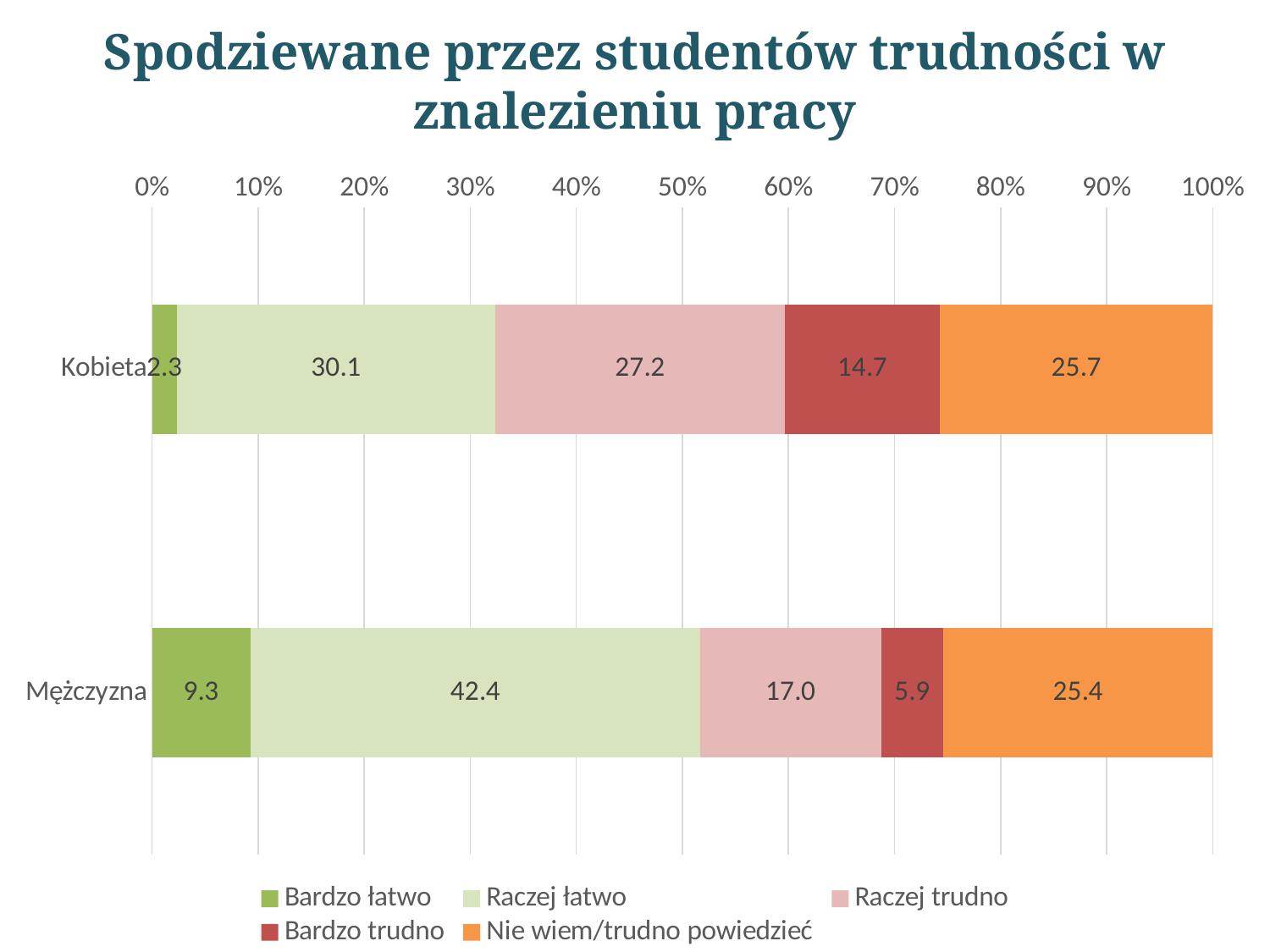
What is the value of "Bardzo trudno" for Mężczyzna? 5.9 What is the value of "Raczej łatwo" for Kobieta? 30.1 What is the difference between the "Raczej łatwo" values for Mężczyzna and Kobieta? 12.3 Which category has the higher value for "Raczej łatwo", Kobieta or Mężczyzna? Mężczyzna Which category has the higher value for "Raczej trudno", Kobieta or Mężczyzna? Kobieta What kind of chart is shown on the slide? Stacked bar chart What is the value of "Nie wiem/trudno powiedzieć" for Kobieta? 25.7 What is the value of "Bardzo łatwo" for Mężczyzna? 9.3 What is the difference between the "Bardzo trudno" values for Kobieta and Mężczyzna? 8.8 Which series has the smallest segment in the Kobieta bar? Bardzo łatwo How many series does the legend list? 5 Which series has the largest segment in the Mężczyzna bar? Raczej łatwo